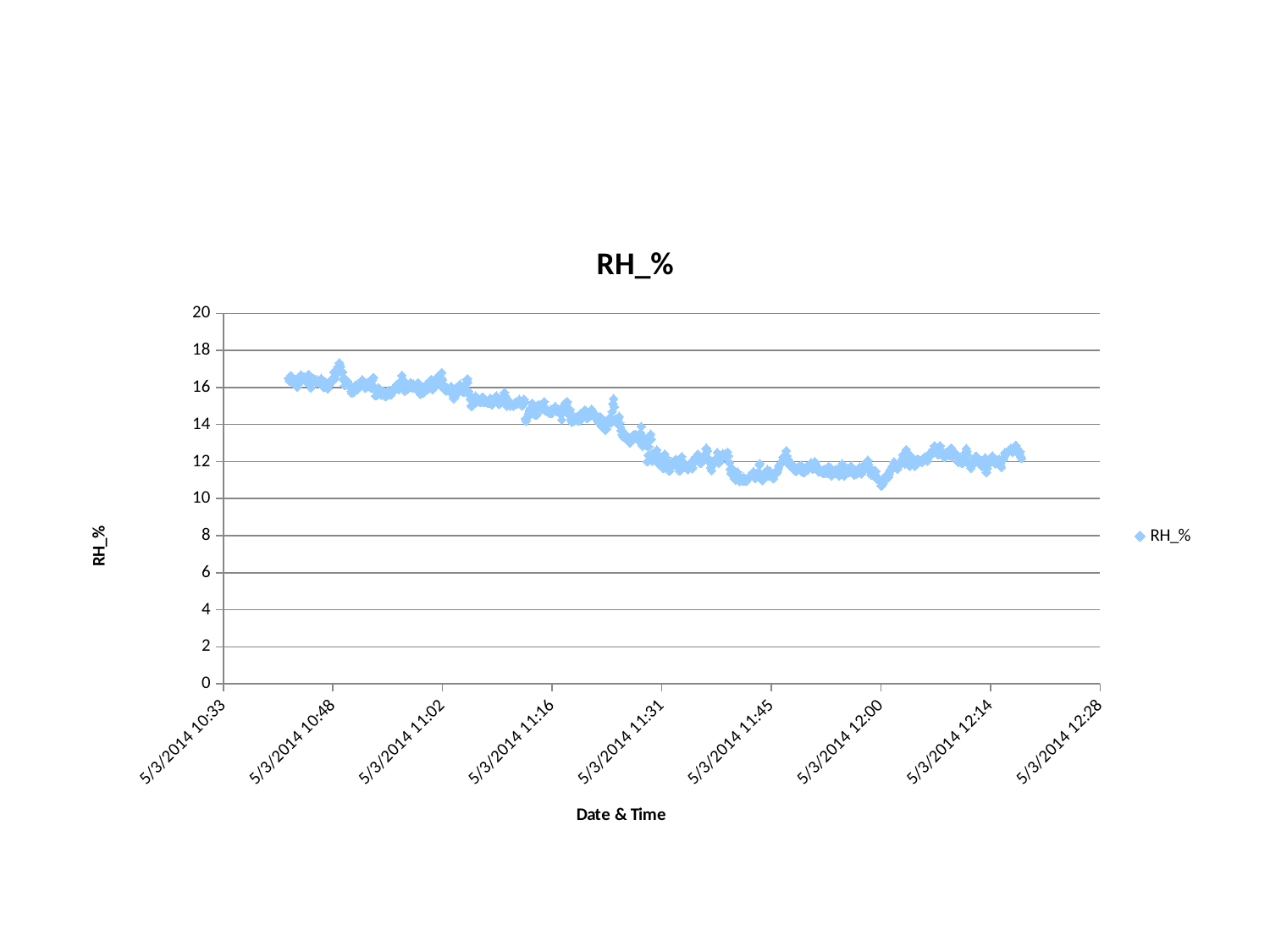
Do the RH_% values generally rise or fall from left to right along the x axis? fall Is the RH_% value at 5/3/2014 11:45 greater or less than 14? less Is the RH_% value at 5/3/2014 11:02 greater or less than 14? greater Is the RH_% value at 5/3/2014 12:14 greater or less than 10? greater How many series does the legend list? 1 What is the label on the x axis of the chart? Date & Time Which of the two times has the higher RH_% value: 5/3/2014 10:48 or 5/3/2014 12:00? 5/3/2014 10:48 What kind of chart is shown on the slide? scatter chart What is the title of the chart? RH_%